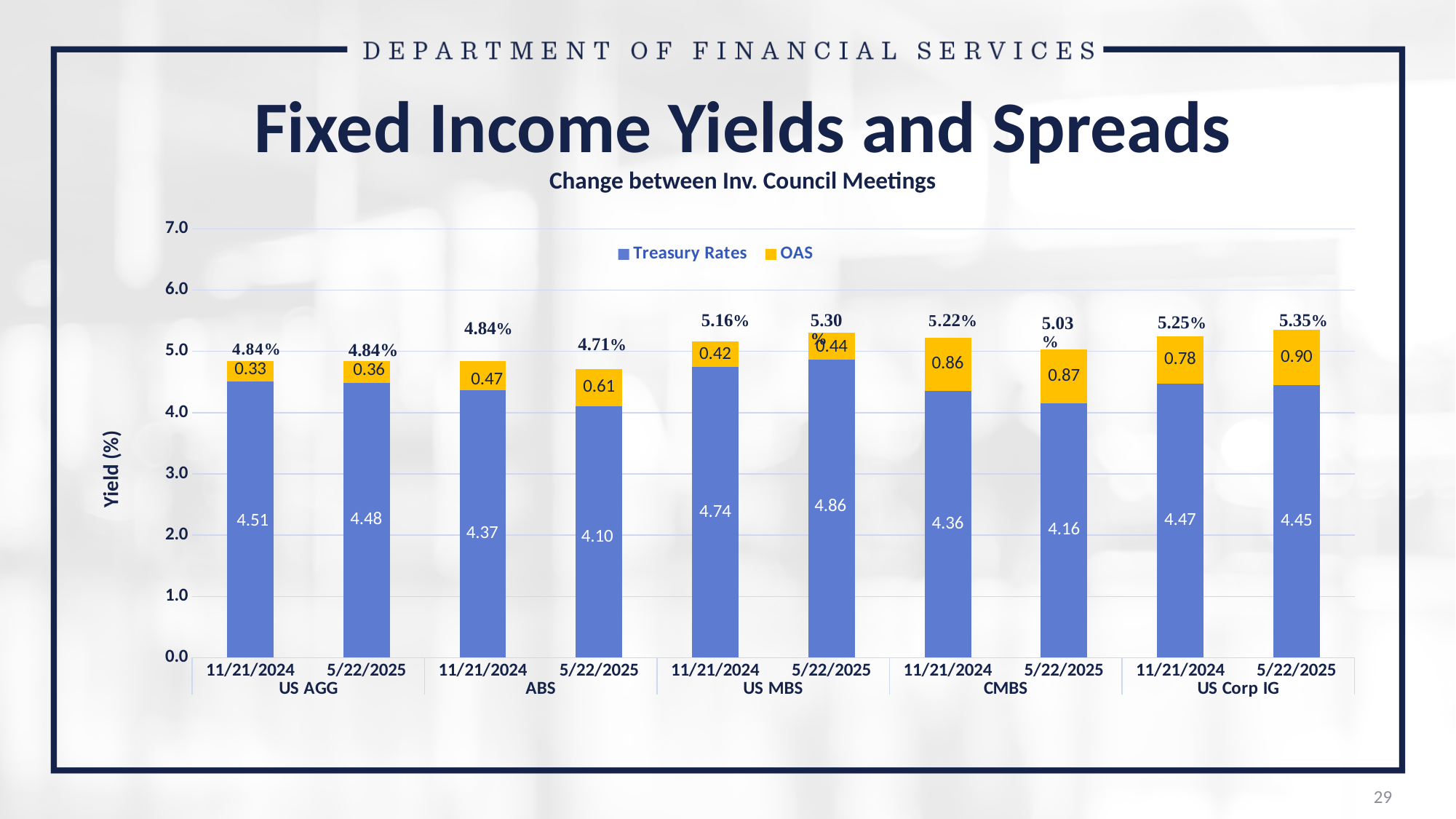
What is the label on the vertical axis of the chart? Yield (%) Which is larger, the Treasury Rates value for CMBS on 11/21/2024 or on 5/22/2025? 11/21/2024 (4.36) What is the total yield printed above the CMBS 11/21/2024 bar? 5.22% What kind of chart is shown on the slide? Stacked bar chart What is the Treasury Rates value for US AGG on 11/21/2024? 4.51 What is the Treasury Rates value for US MBS on 5/22/2025? 4.86 Which bar has the lowest total yield printed above it? ABS 5/22/2025 (4.71%) How many bars are plotted in the chart? 10 How many series does the legend list? 2 Which bar has the highest total yield printed above it? US Corp IG 5/22/2025 (5.35%) What is the difference between the OAS values for ABS on 5/22/2025 and 11/21/2024? 0.14 What is the OAS value for US Corp IG on 5/22/2025? 0.90